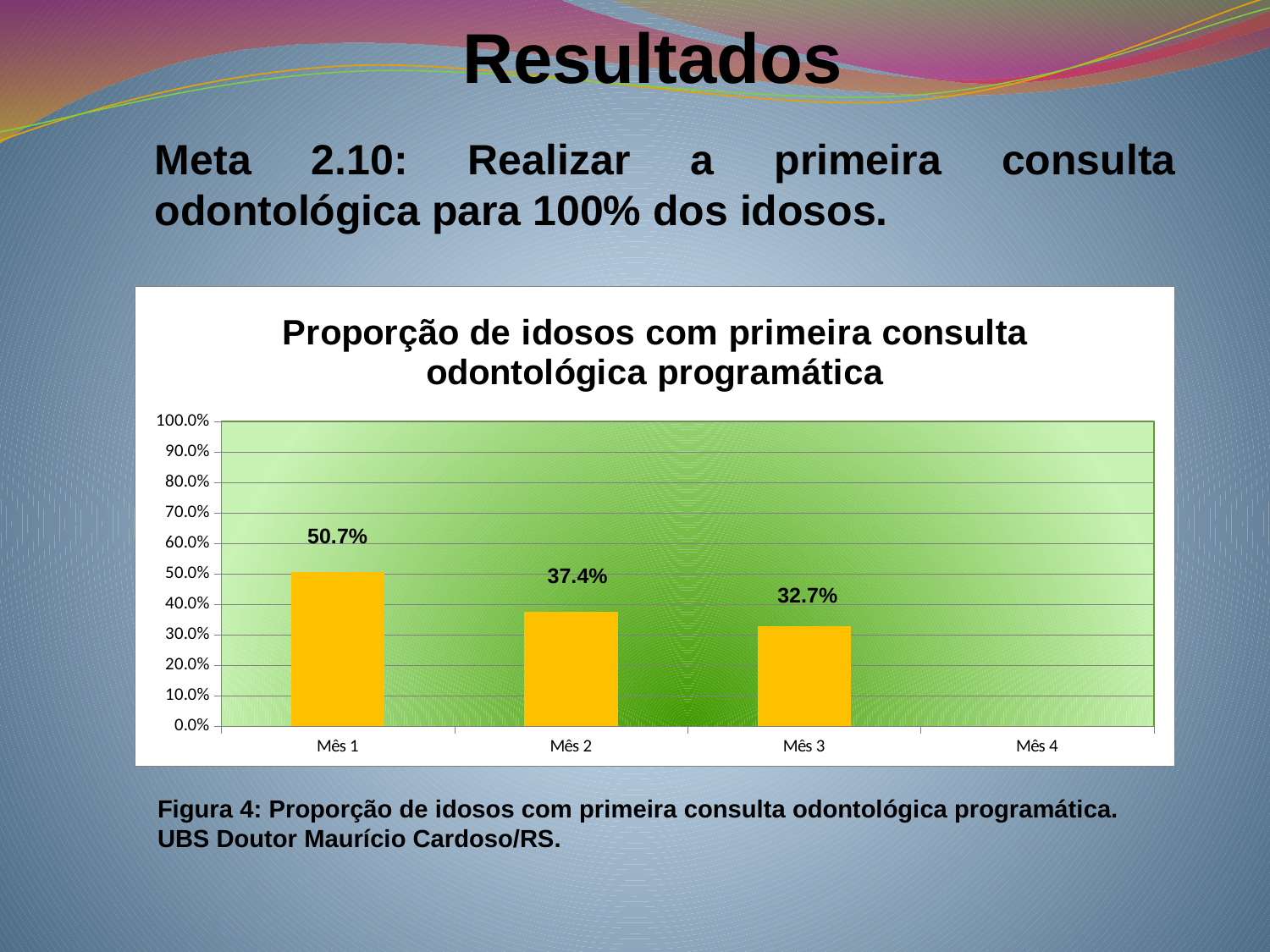
Which month has the highest value? Mês 1 What kind of chart is shown? Bar chart What is the difference between the values for Mês 2 and Mês 3? 4.7% Do the values rise or fall from Mês 1 to Mês 3? Fall What is the difference between the values for Mês 1 and Mês 2? 13.3% Among the months with a plotted bar, which has the lowest value? Mês 3 What is the value for Mês 1? 50.7% What is the value for Mês 3? 32.7% What is the value for Mês 2? 37.4% Which is larger, the value for Mês 2 or the value for Mês 3? Mês 2 How many month categories are shown on the x axis? 4 Is the value for Mês 1 greater or less than 40.0%? greater